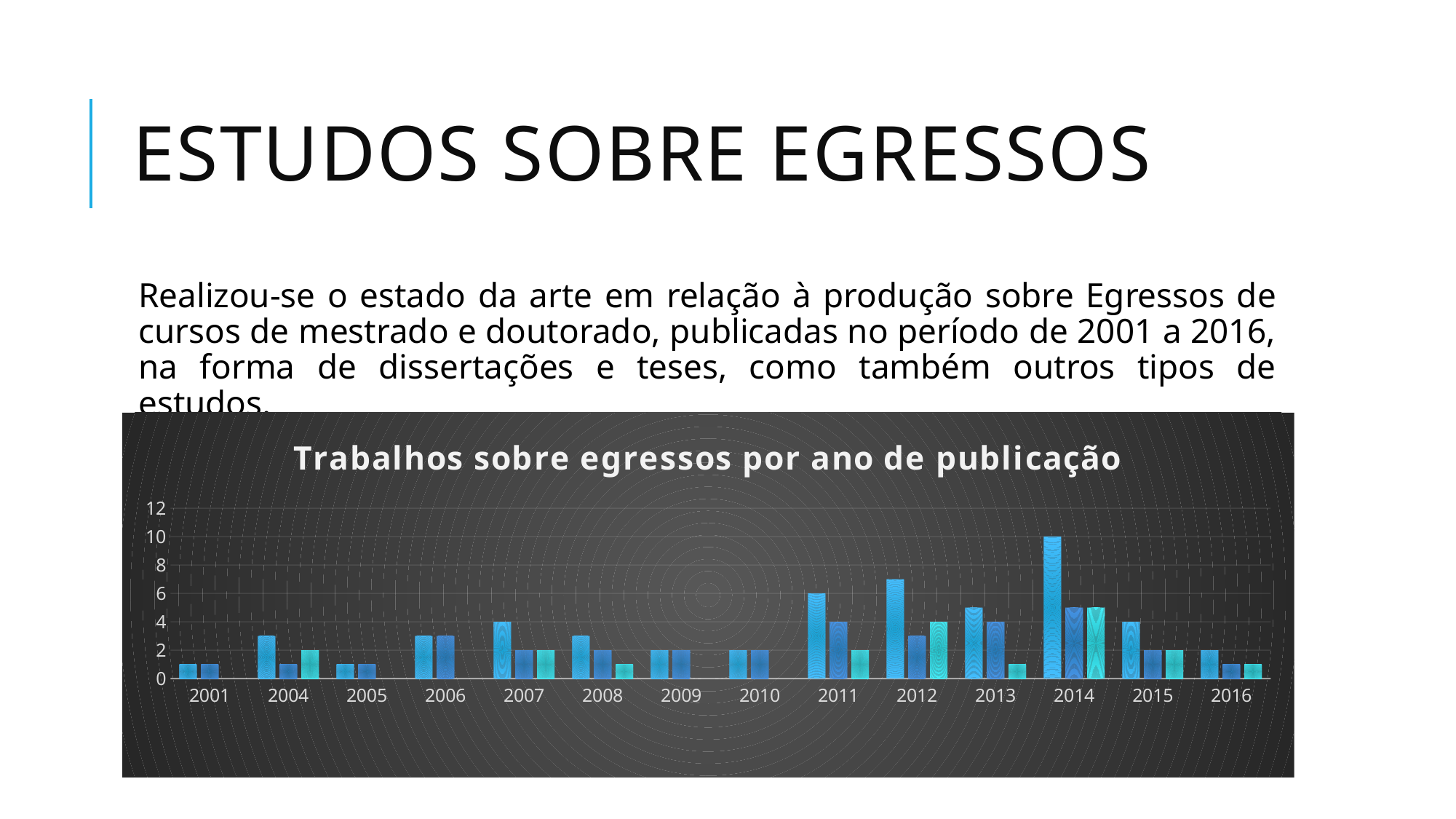
What value do the bars in the 2009 group reach? 2 What kind of chart is shown on the slide? bar chart Is the leftmost bar for 2013 greater or less than 4? greater What value does the tallest bar in the chart (in the 2014 group) reach? 10 What value does the leftmost bar in the 2011 group reach? 6 Which year has a taller tallest bar, 2011 or 2008? 2011 How many years are shown on the x axis of the chart? 14 Is the tallest bar for 2012 greater or less than 6? greater How many bars are shown for the year 2001? 2 Is the tallest bar for 2001 greater or less than 2? less Which year has the tallest bar in the chart? 2014 What is the title of the chart? Trabalhos sobre egressos por ano de publicação